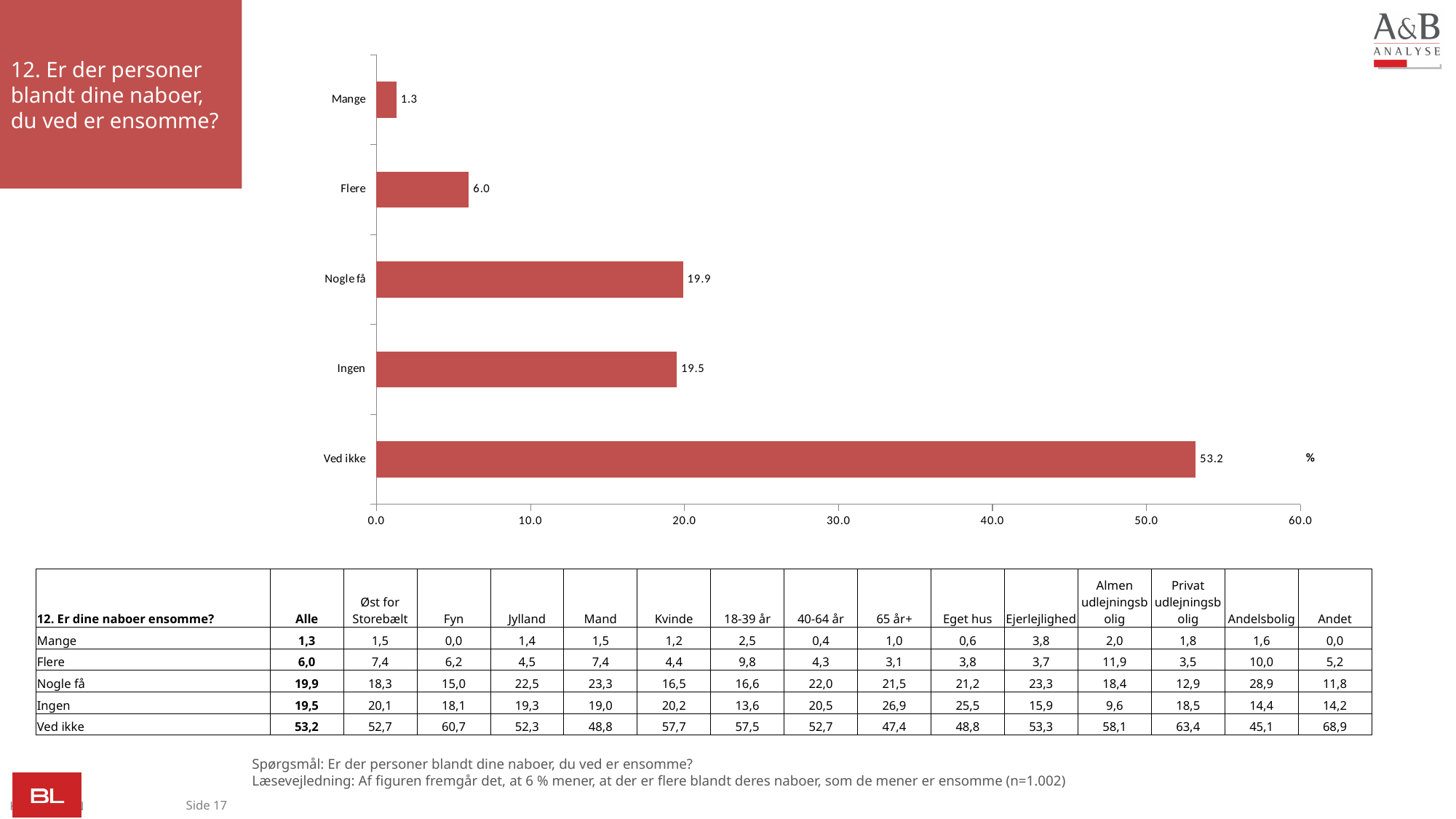
How many categories are shown in the chart? 5 What kind of chart is shown on the slide? bar chart Which is larger, the value for "Flere" or the value for "Ingen"? Ingen Which category has the highest value in the chart? Ved ikke What is the difference between the values for "Ved ikke" and "Ingen"? 33.7 Is the value for "Ved ikke" greater or less than 50.0? greater What is the value for "Nogle få" in the chart? 19.9 What is the value for "Mange" in the chart? 1.3 What is the value for "Flere" in the chart? 6.0 What is the value for "Ved ikke" in the chart? 53.2 Which category has the lowest value in the chart? Mange What is the difference between the values for "Flere" and "Mange"? 4.7